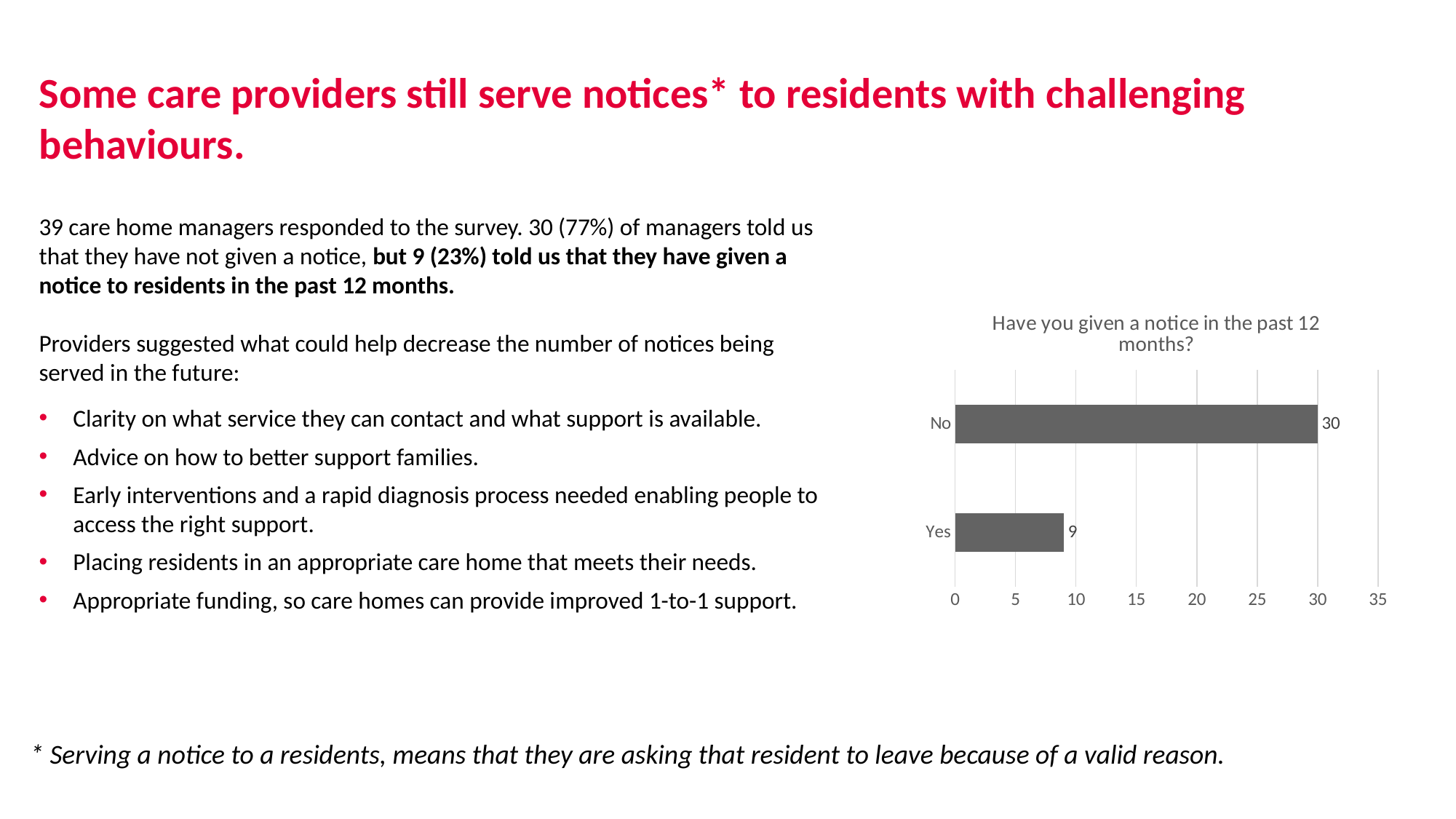
What kind of chart is shown on the slide? bar chart Is the value for "No" greater or less than 25? greater Which category has the highest value in the chart? No Which is larger, the value for "No" or the value for "Yes"? No What is the title of the chart? Have you given a notice in the past 12 months? Which category has the lowest value in the chart? Yes What is the value for "Yes" in the chart? 9 What is the highest value shown on the chart's horizontal axis? 35 Is the value for "Yes" greater or less than 10? less What is the difference between the values for "No" and "Yes"? 21 How many categories are shown in the chart? 2 What is the value for "No" in the chart? 30